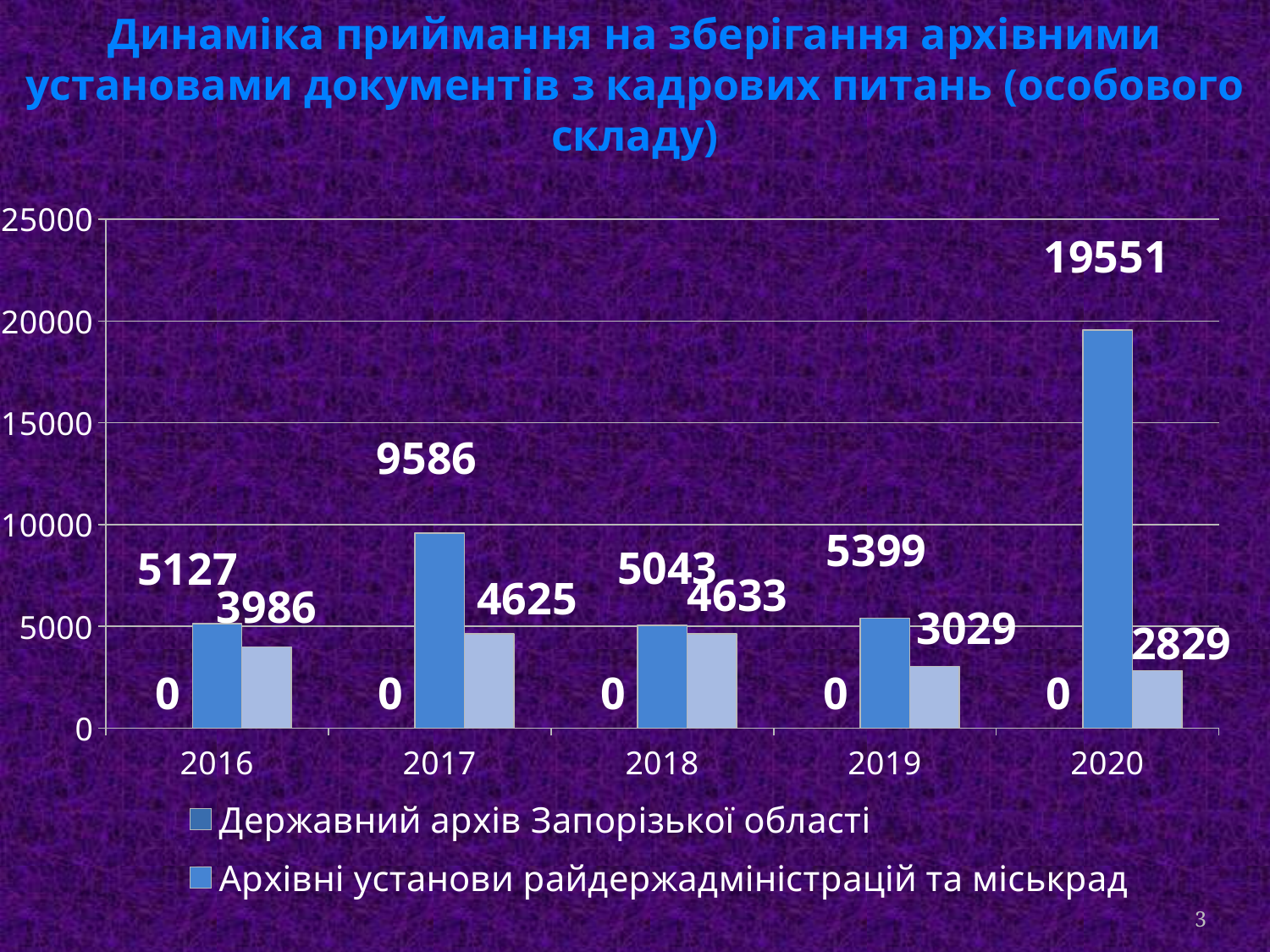
What is the value for Архівні установи райдержадміністрацій та міськрад in 2017? 9586 What is the difference between the Державний архів Запорізької області value and the Архівні установи райдержадміністрацій та міськрад value in 2020? 19551 What kind of chart is shown on the slide? bar chart How many years are shown on the x axis? 5 How many series does the legend list? 2 Which is larger in 2019: the value for Державний архів Запорізької області or for Архівні установи райдержадміністрацій та міськрад? Архівні установи райдержадміністрацій та міськрад Does the value for Архівні установи райдержадміністрацій та міськрад rise or fall from 2018 to 2020? rise In which year is the value for Архівні установи райдержадміністрацій та міськрад lowest? 2018 What is the value for Державний архів Запорізької області in 2020? 0 Is the value for Державний архів Запорізької області in 2017 greater or less than 10000? less What is the value for Державний архів Запорізької області in 2018? 0